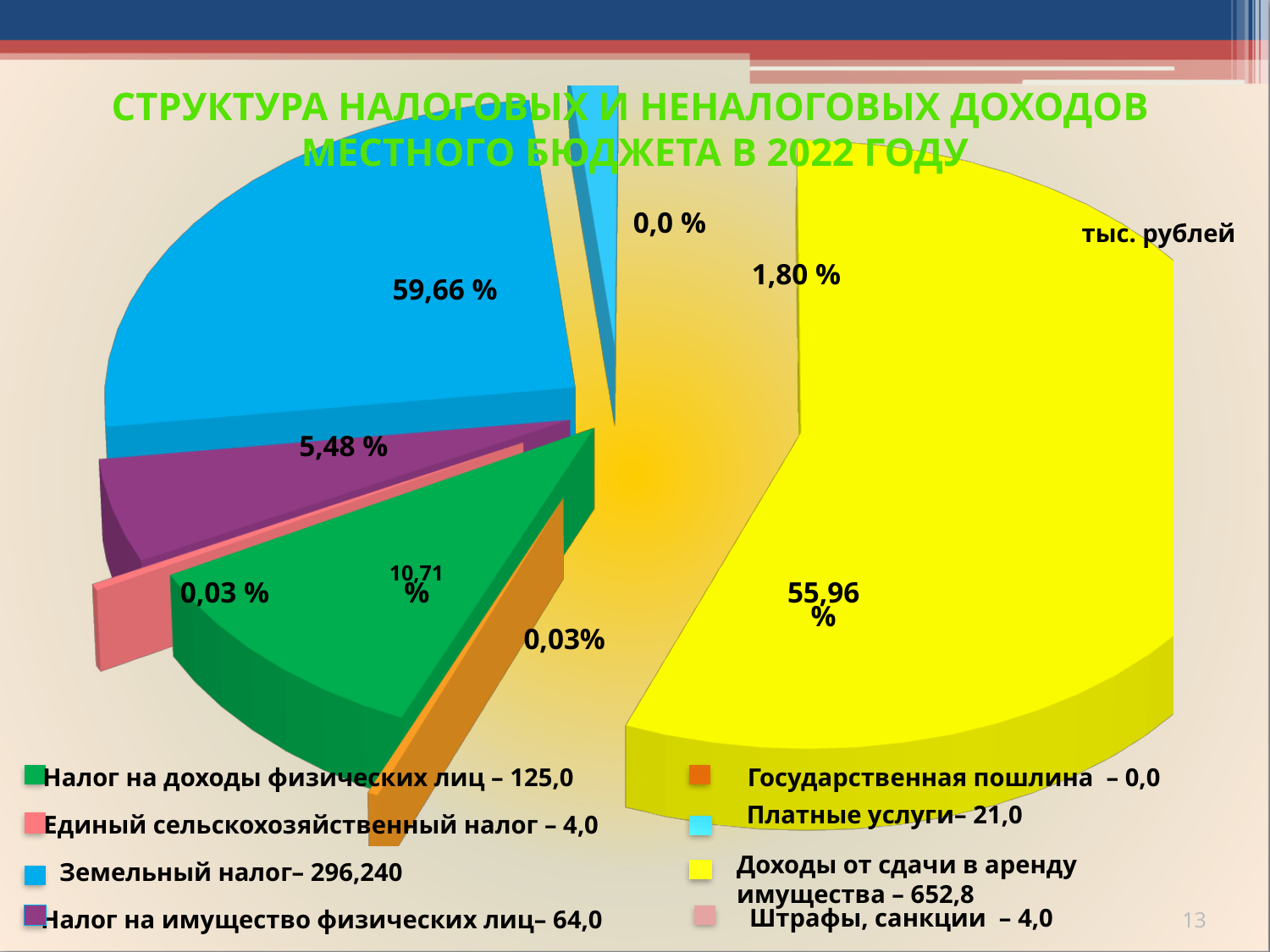
Which is larger: Налог на доходы физических лиц or Налог на имущество физических лиц? Налог на доходы физических лиц What unit is indicated for the values on the chart? тыс. рублей What kind of chart is shown on the slide? pie chart What is the difference between Налог на доходы физических лиц (125,0) and Налог на имущество физических лиц (64,0)? 61,0 What percentage share is labelled on the yellow slice? 55,96 % What is the value for Налог на доходы физических лиц? 125,0 What is the value for Доходы от сдачи в аренду имущества? 652,8 What is the value for Земельный налог in the legend? 296,240 Which category has the largest value? Доходы от сдачи в аренду имущества What is the value for Платные услуги? 21,0 How many entries does the legend list? 8 Which category has the smallest value? Государственная пошлина